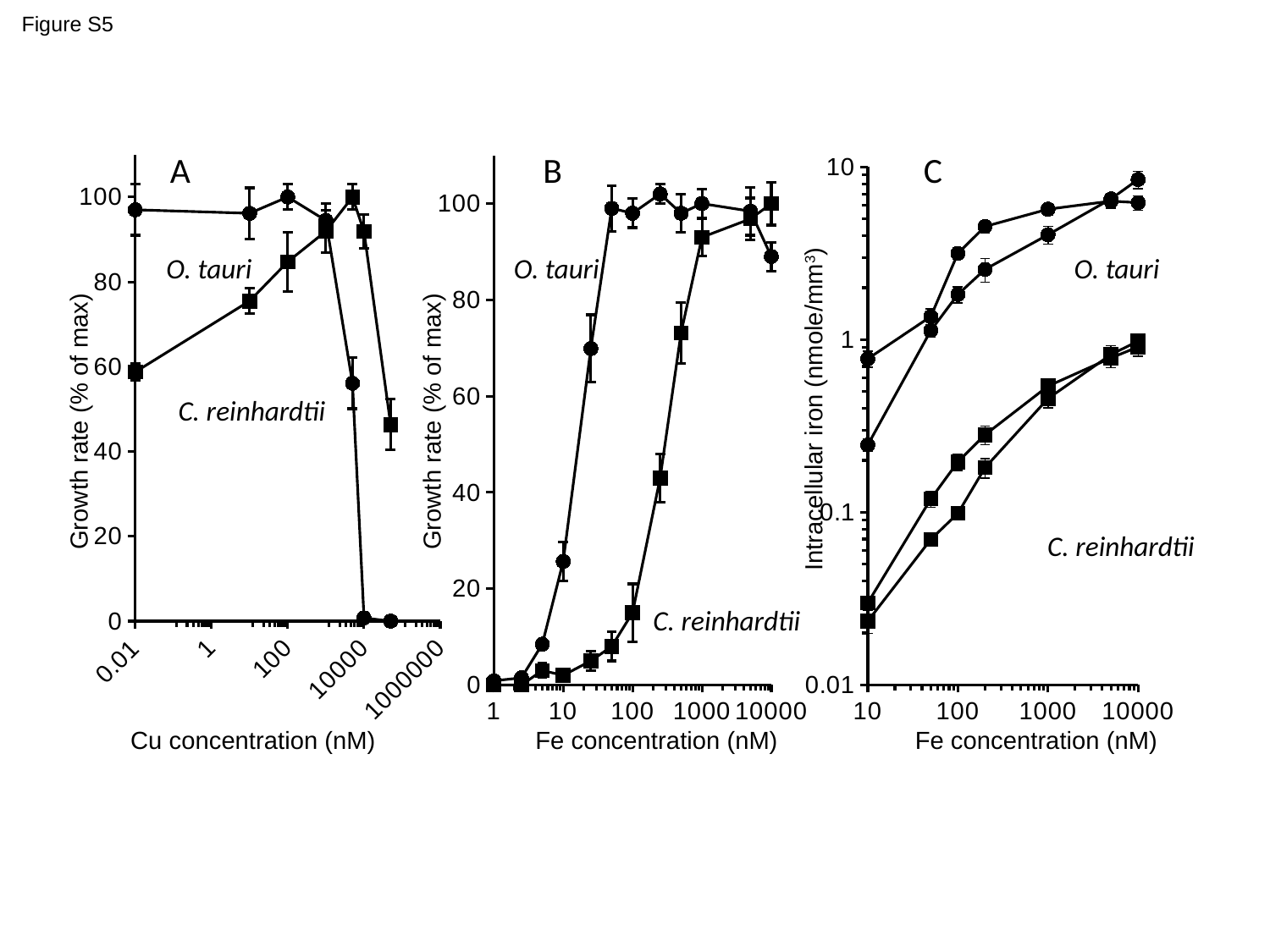
In panel C, is the intracellular iron of C. reinhardtii at 10 nM Fe greater or less than 0.1? less What kind of chart is panel A? line chart In panel B, is the growth rate of O. tauri at 100 nM Fe greater or less than 80? greater In panel B, is the growth rate of C. reinhardtii at 100 nM Fe greater or less than 40? less In panel A, what is the x-axis label? Cu concentration (nM) In panel A, which species has the higher growth rate at the lowest Cu concentration, O. tauri or C. reinhardtii? O. tauri In panel C, what is the y-axis label? Intracellular iron (nmole/mm³) In panel B, does the growth rate of O. tauri rise or fall as Fe concentration increases from 1 to 100 nM? rise In panel C, which species has the higher intracellular iron at 10000 nM Fe, O. tauri or C. reinhardtii? O. tauri